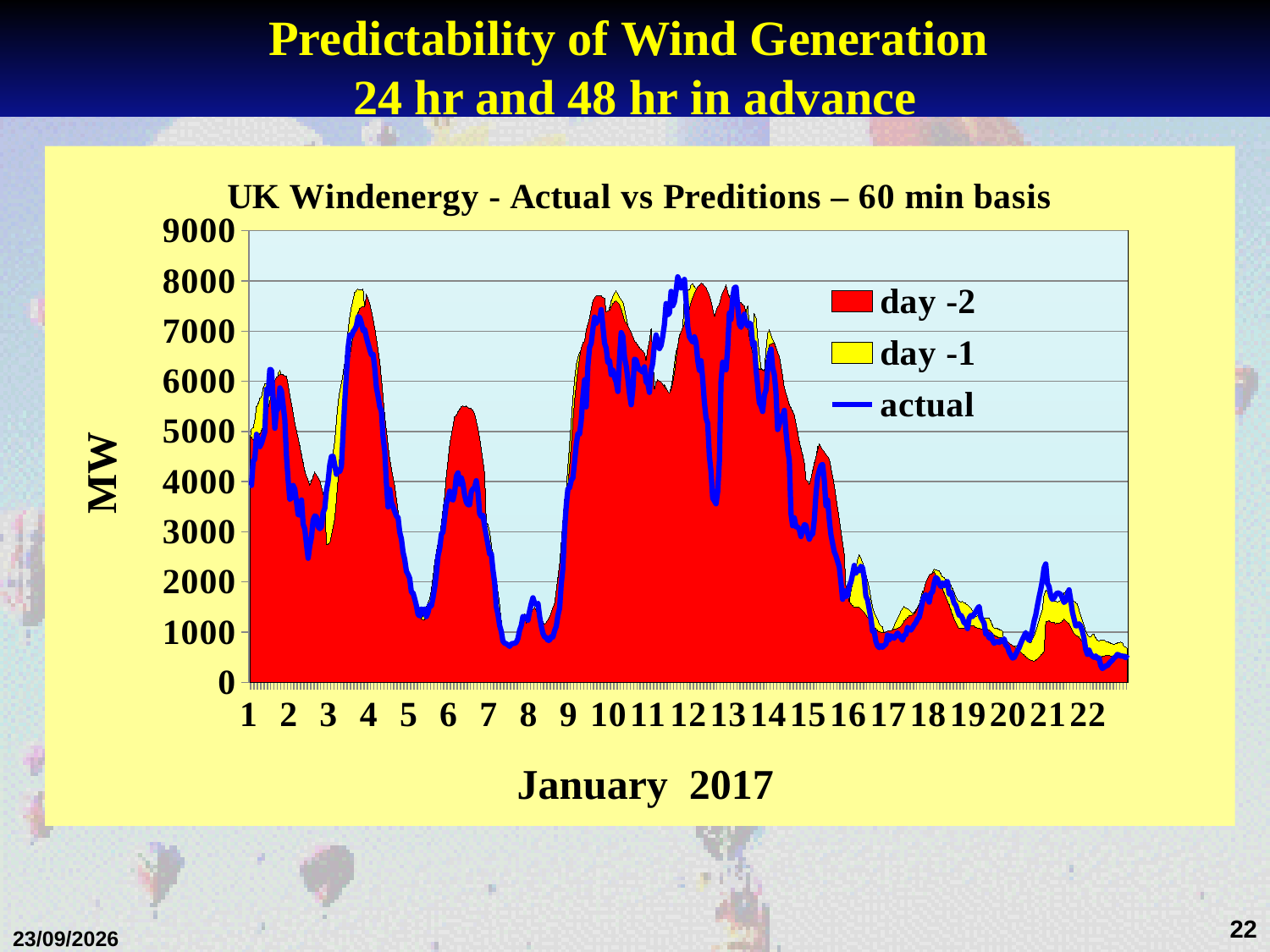
How many series does the legend list? 3 Is the actual value around day 12 larger or smaller than the actual value around day 20? larger Is the peak actual value around day 4 greater or less than 6000 MW? greater Is the actual value around day 8 greater or less than 2000 MW? less Is the actual value around day 22 greater or less than 1000 MW? less What kind of chart is this? area chart with a line series How many days are labelled on the x axis? 22 Do the values generally rise or fall from day 14 to day 22? fall What are the three series named in the legend? day -2, day -1, actual What is the title of the chart? UK Windenergy - Actual vs Preditions – 60 min basis